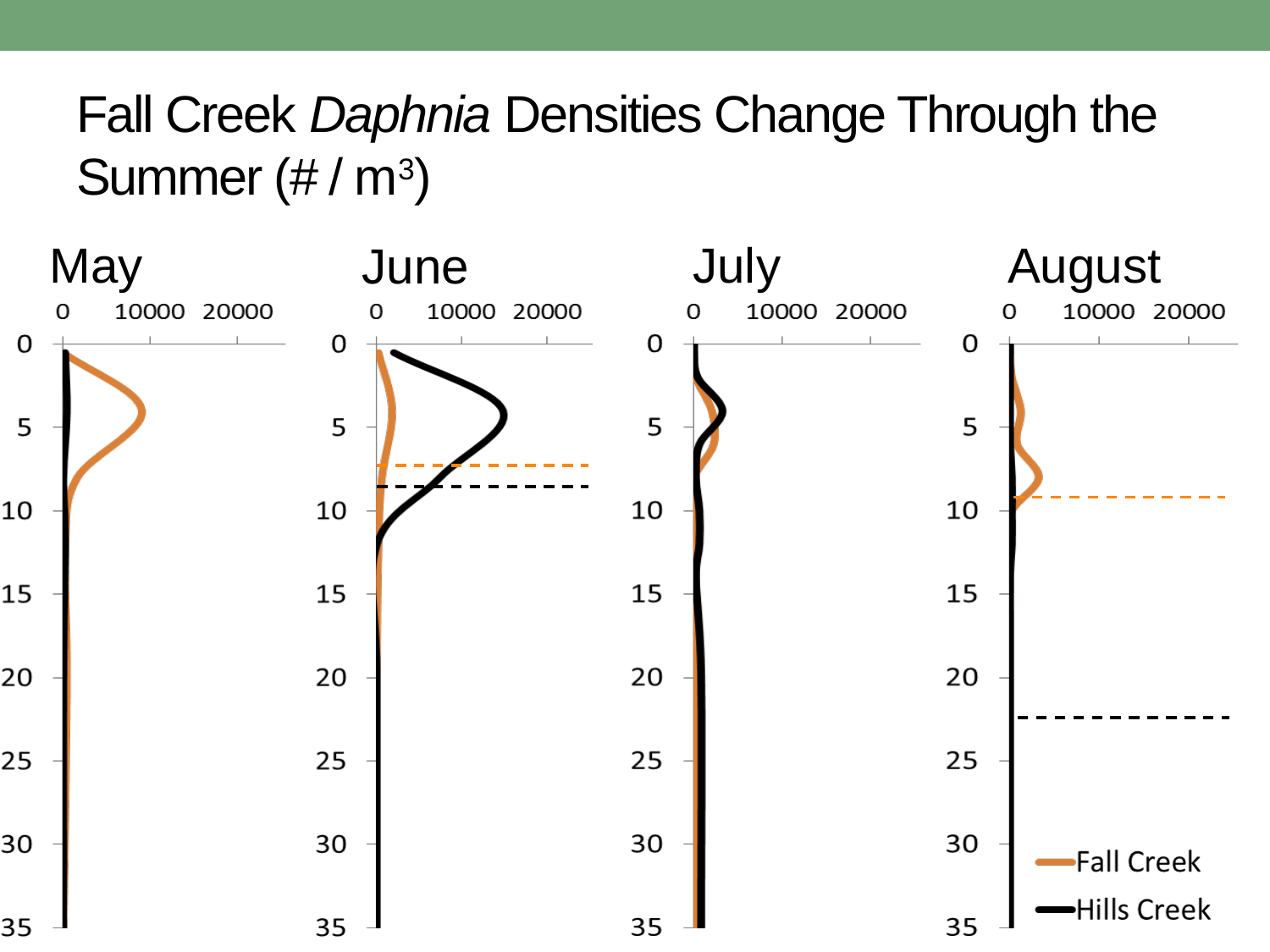
How many monthly charts are shown on the slide? 4 Which series is drawn in orange according to the legend? Fall Creek In the August chart, is the peak value for Fall Creek greater or less than 10000? less In the June chart, which series reaches the higher peak density, Fall Creek or Hills Creek? Hills Creek In the June chart, is the peak value for Fall Creek greater or less than 10000? less In the May chart, which series reaches the higher peak density, Fall Creek or Hills Creek? Fall Creek In the June chart, is the peak value for Hills Creek greater or less than 10000? greater Which series is drawn in black according to the legend? Hills Creek What kind of chart is used for each month on this slide? line chart How many series does the legend list? 2